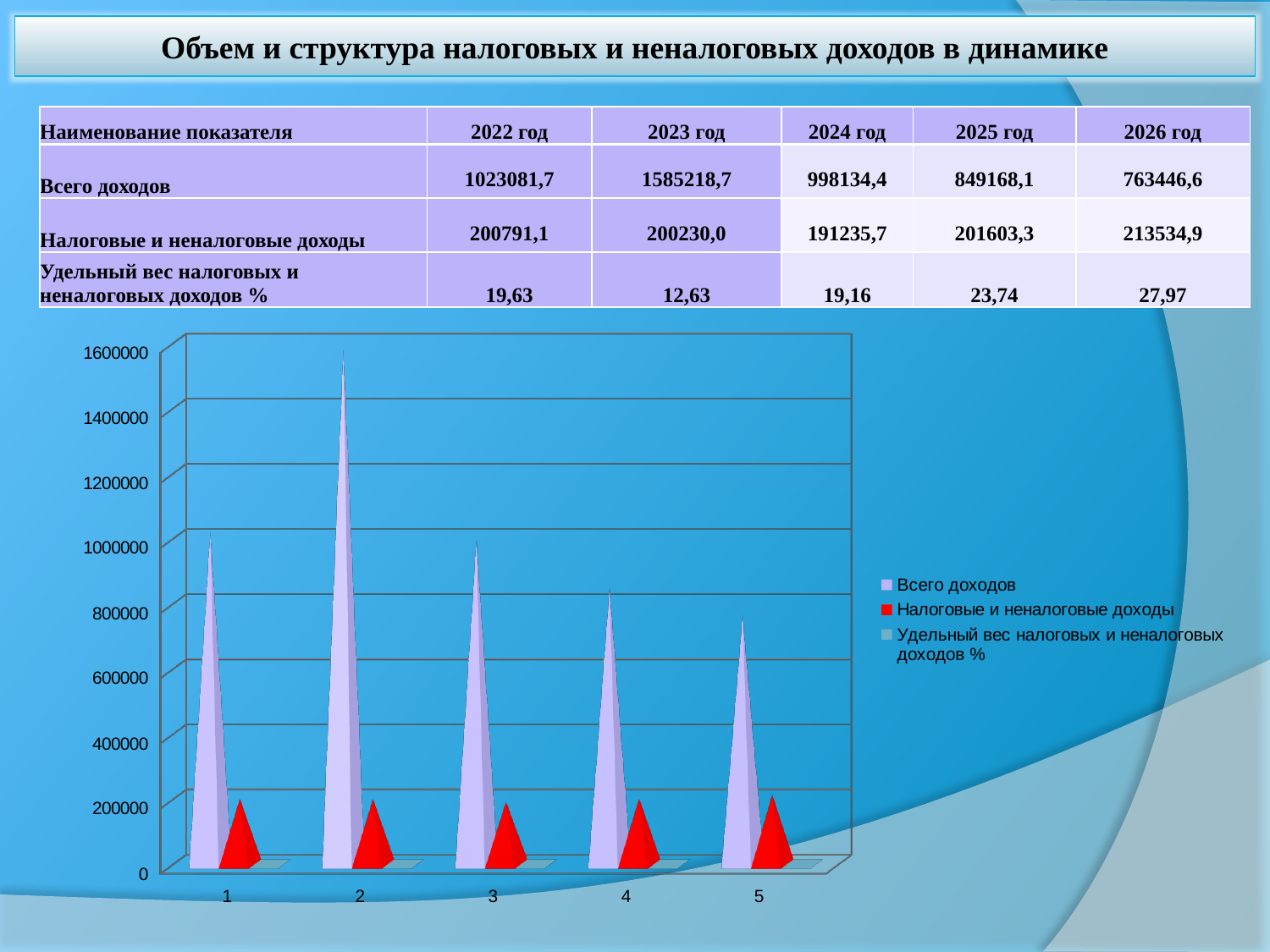
Is the value of "Всего доходов" for category 5 greater or less than 800000? less Is the value of "Налоговые и неналоговые доходы" for category 3 greater or less than 400000? less What kind of chart is shown on the slide? bar chart Which is larger for "Всего доходов": category 2 or category 1? category 2 Is the value of "Всего доходов" for category 2 greater or less than 1400000? greater Which category has the highest value for the series "Всего доходов"? 2 How many categories are shown along the x axis of the chart? 5 How many series does the chart legend list? 3 Do the values of "Всего доходов" rise or fall from category 2 to category 5? fall Which is larger for category 4: "Всего доходов" or "Налоговые и неналоговые доходы"? Всего доходов What colour represents the series "Налоговые и неналоговые доходы" in the chart? red Which category has the lowest value for the series "Всего доходов"? 5